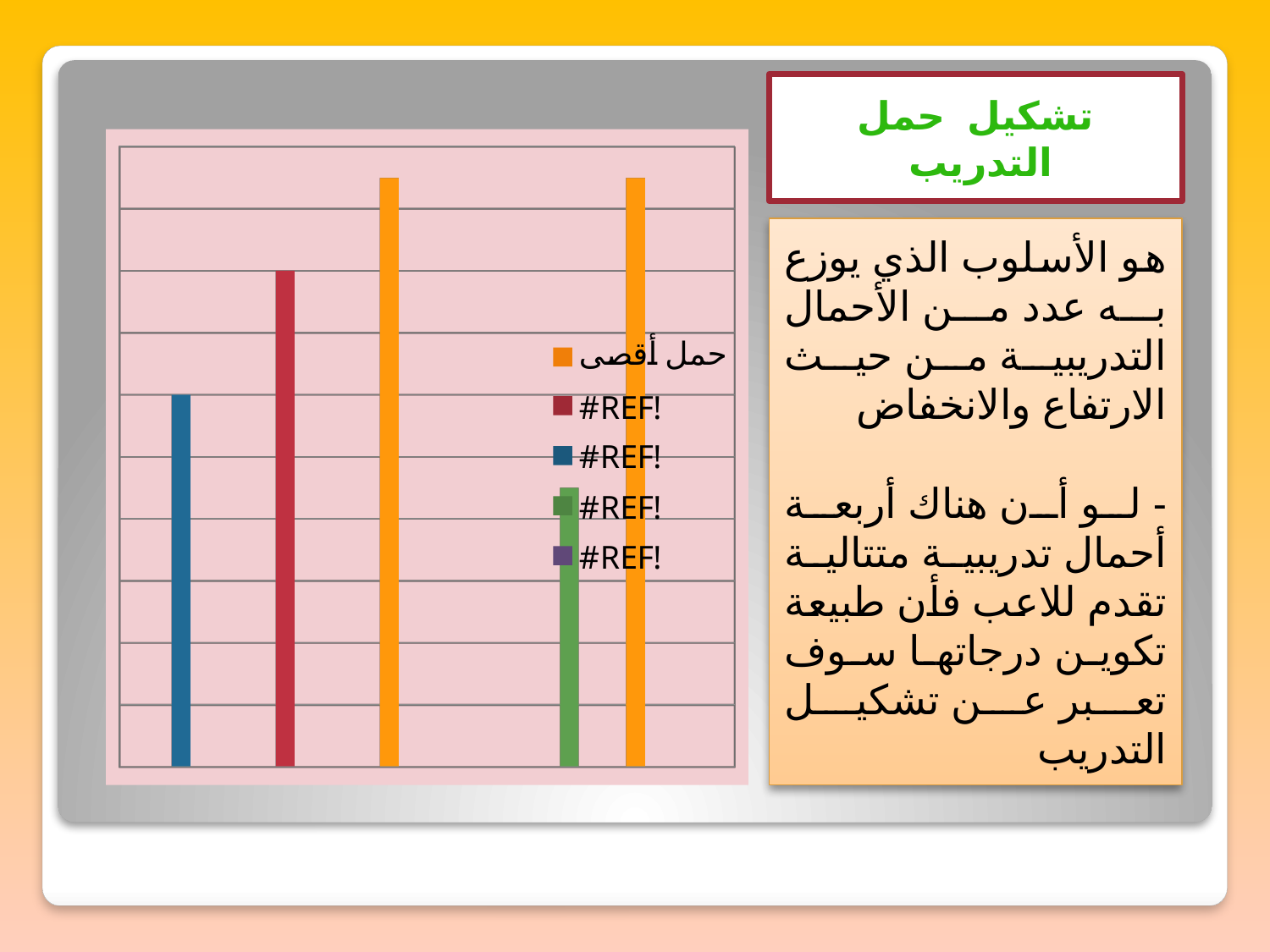
Which is taller, the blue bar or the green bar? blue Which colour of bar is the shortest in the chart? green How many bars are plotted in the chart? 5 What kind of chart is shown on the slide? bar chart How many legend entries read "#REF!"? 4 How many entries does the chart's legend list? 5 Which is taller, the red bar or the blue bar? red Which colour of bar reaches the highest in the chart? orange Which legend entry is shown with the orange colour? حمل أقصى Which is taller, the orange bar or the red bar? orange